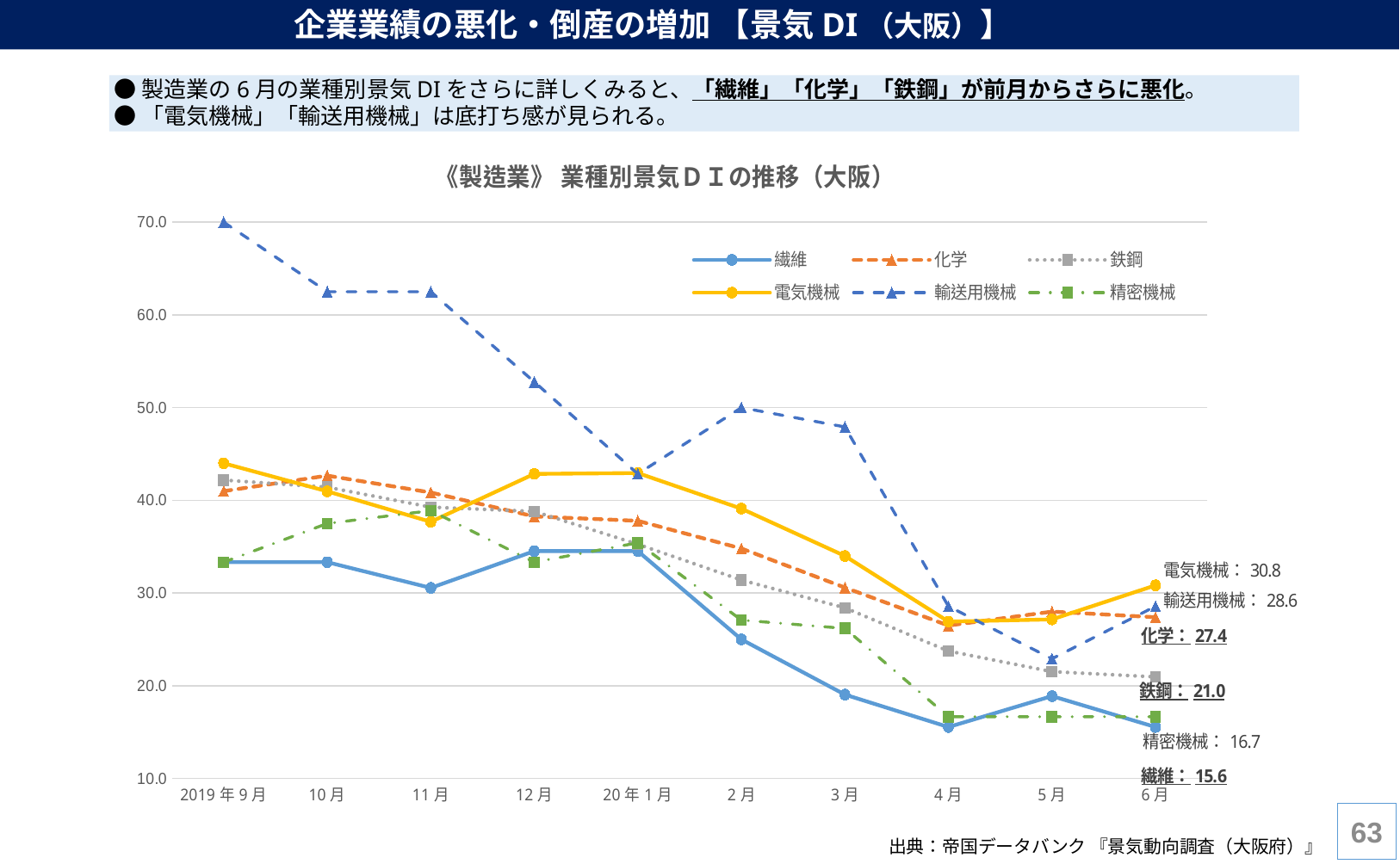
Is the value for 輸送用機械 in 2019年9月 greater or less than 60.0? greater What kind of chart is shown on the slide? line chart Which series has the highest value in 6月? 電気機械 Does the 鉄鋼 series rise or fall from 2019年9月 to 6月? fall What is the value for 鉄鋼 in 6月? 21.0 Which series has the lowest value in 6月? 繊維 What is the value for 精密機械 in 6月? 16.7 What is the value for 電気機械 in 6月? 30.8 How many series does the legend list? 6 How many time points are shown on the x axis? 10 What is the difference between 輸送用機械 and 化学 in 6月? 1.2 What is the value for 繊維 in 6月? 15.6